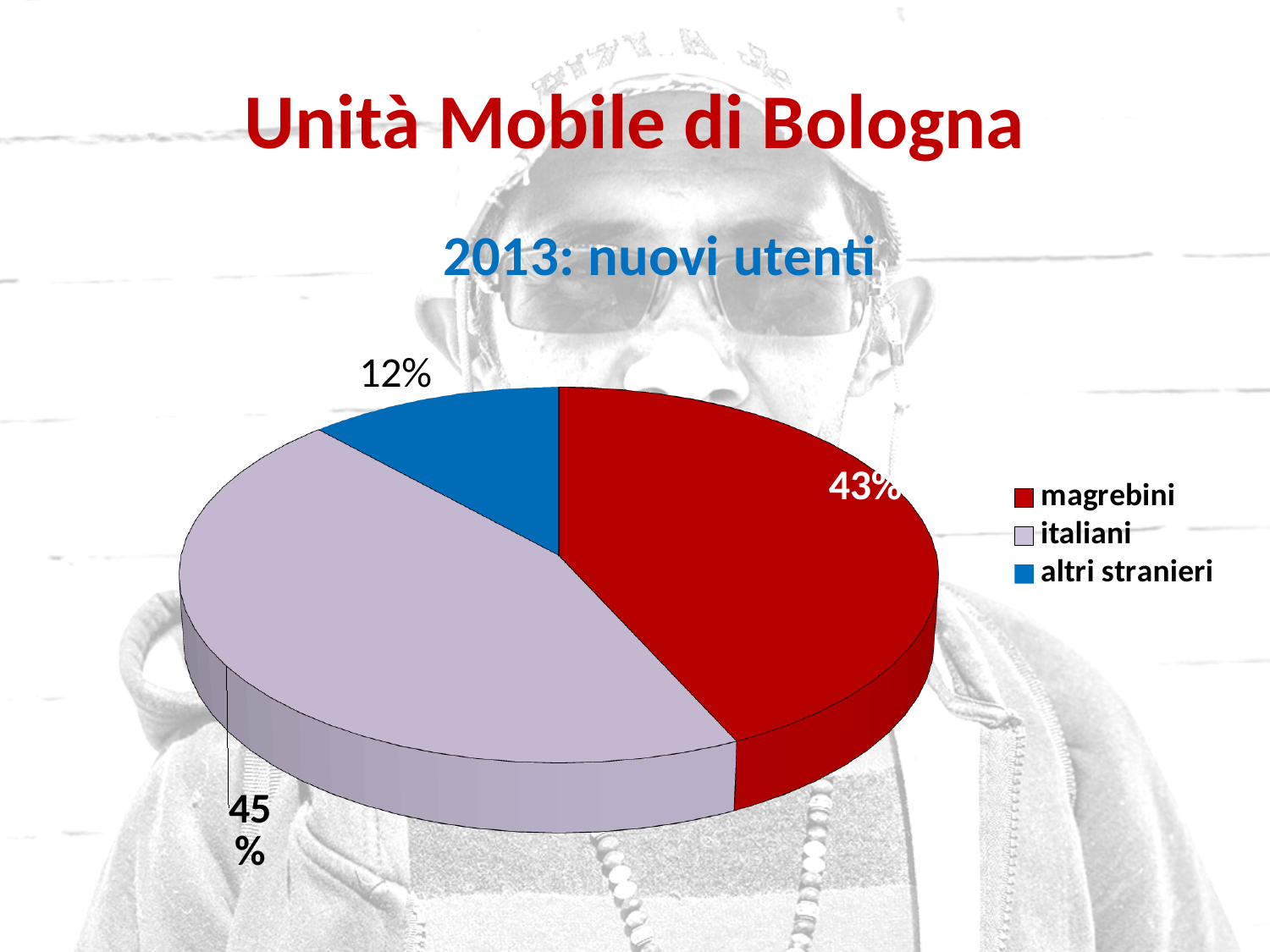
How many categories does the legend list? 3 What share of the pie is labelled for magrebini? 43% What share of the pie is labelled for altri stranieri? 12% What is the difference in percentage points between the magrebini and altri stranieri slices? 31 What share of the pie is labelled for italiani? 45% What is the title of the chart? 2013: nuovi utenti What colour is the slice for altri stranieri? blue Which slice is larger, magrebini or altri stranieri? magrebini Which category has the smallest slice of the pie? altri stranieri What is the difference in percentage points between the italiani and magrebini slices? 2 Which category has the largest slice of the pie? italiani What kind of chart is shown on the slide? pie chart